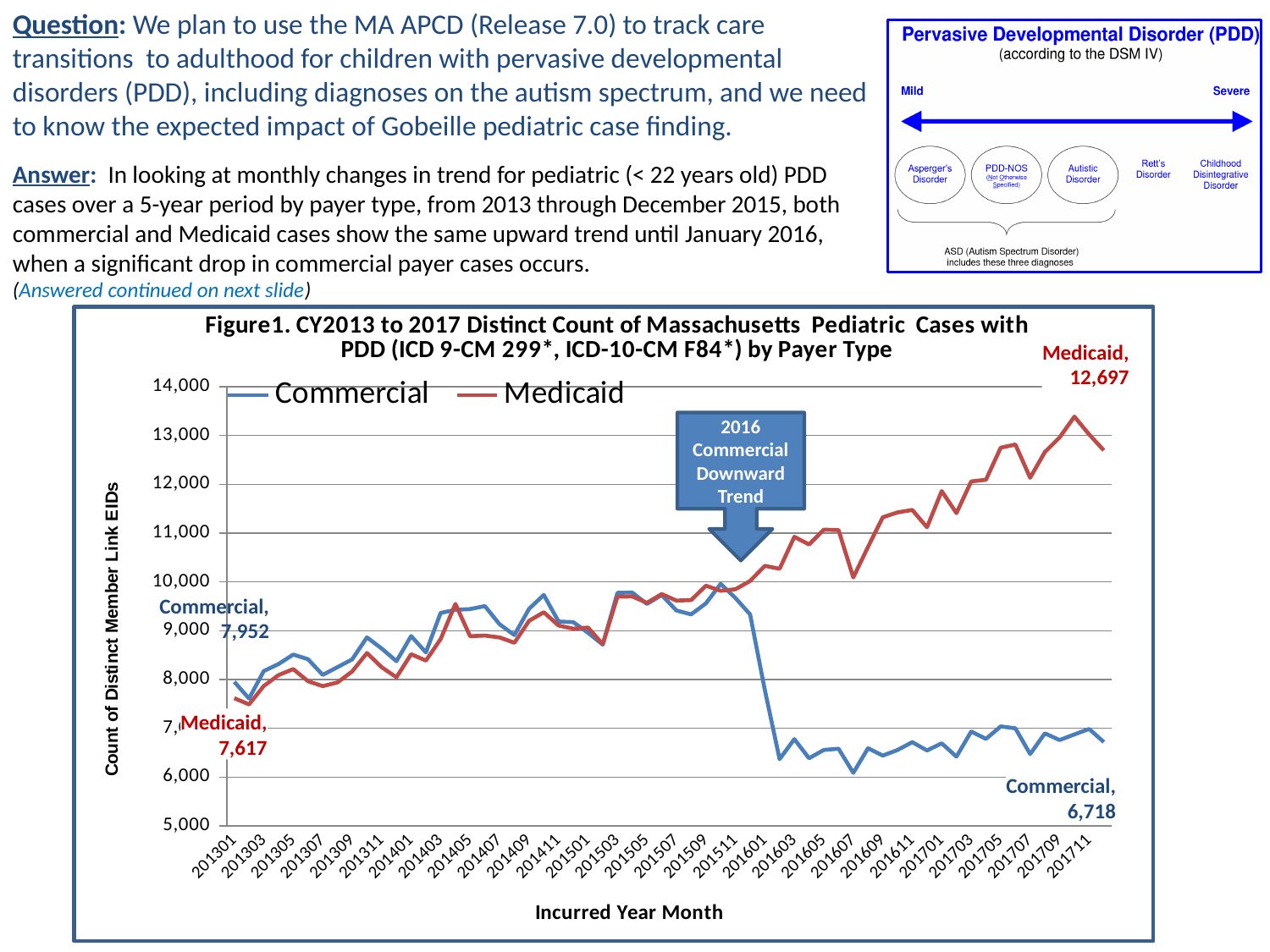
What is the labelled Medicaid value at the start of the series in Figure 1? 7,617 What is the difference between the final labelled Medicaid value and the final labelled Commercial value in Figure 1? 5,979 At the start of the series in Figure 1, which payer type has the larger labelled value, Commercial or Medicaid? Commercial By how much did the labelled Medicaid value increase from the start to the end of the series in Figure 1? 5,080 What is the labelled Commercial value at the start of the series in Figure 1? 7,952 How many series does the legend of Figure 1 list? 2 What is the labelled Medicaid value at the end of the series in Figure 1? 12,697 Is the Commercial value at 201603 in Figure 1 greater or less than 7,000? less Does the Medicaid line in Figure 1 generally rise or fall from 201301 to 201711? rise What is the labelled Commercial value at the end of the series in Figure 1? 6,718 What is the y-axis title of Figure 1? Count of Distinct Member Link EIDs What kind of chart is Figure 1? Line chart